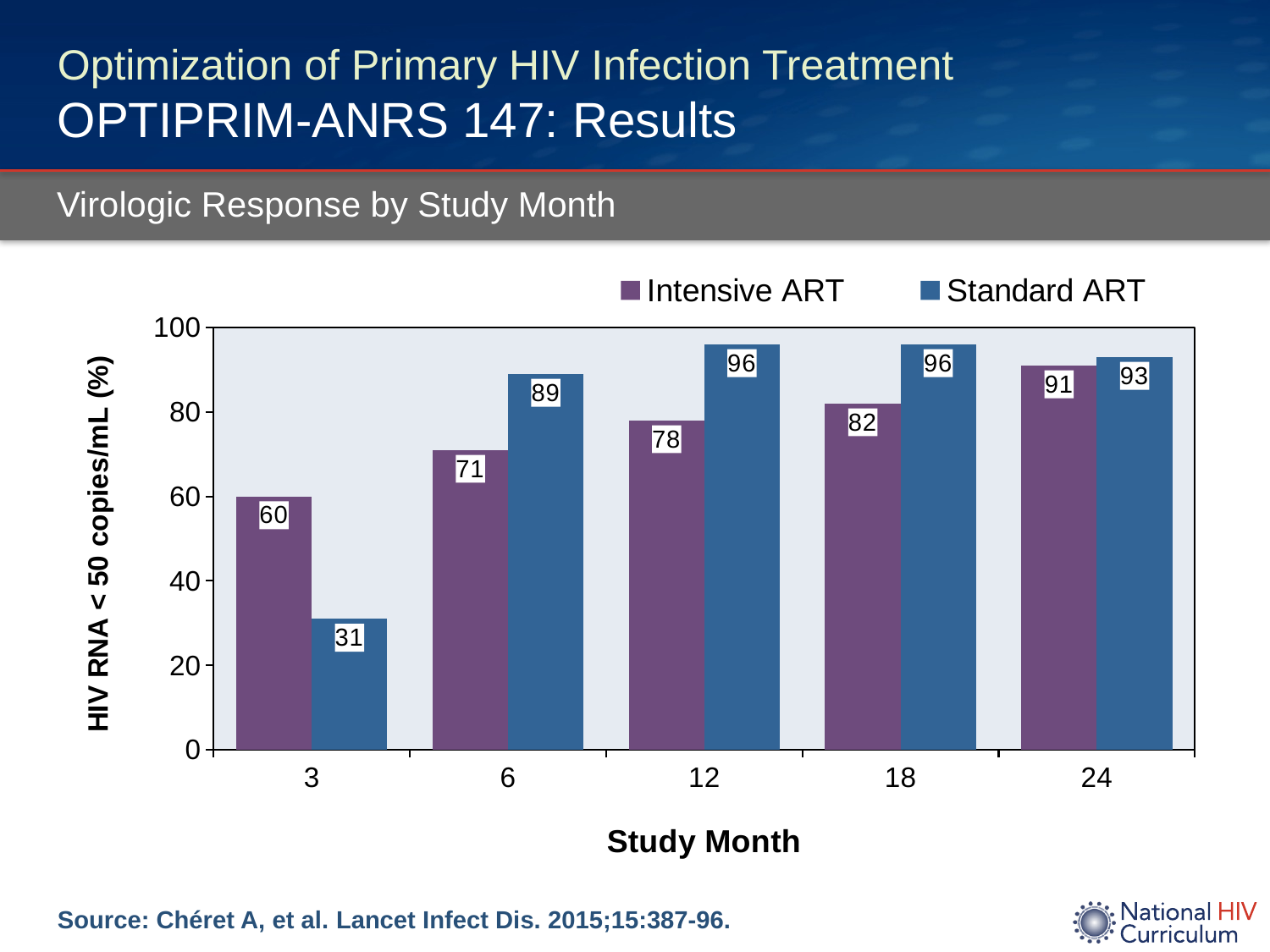
How many study months are shown on the x axis? 5 What kind of chart is shown on the slide? Bar chart At which study month is the Standard ART value lowest? 3 Which series has the larger value at study month 3, Intensive ART or Standard ART? Intensive ART What is the value for Standard ART at study month 24? 93 At which study month is the Intensive ART value highest? 24 What is the difference between the Standard ART and Intensive ART values at study month 12? 18 What is the value for Standard ART at study month 6? 89 Do the Intensive ART values rise or fall from study month 3 to study month 24? Rise How many series does the legend list? 2 Is the value for Intensive ART at study month 18 greater or less than 80? greater What is the value for Intensive ART at study month 3? 60